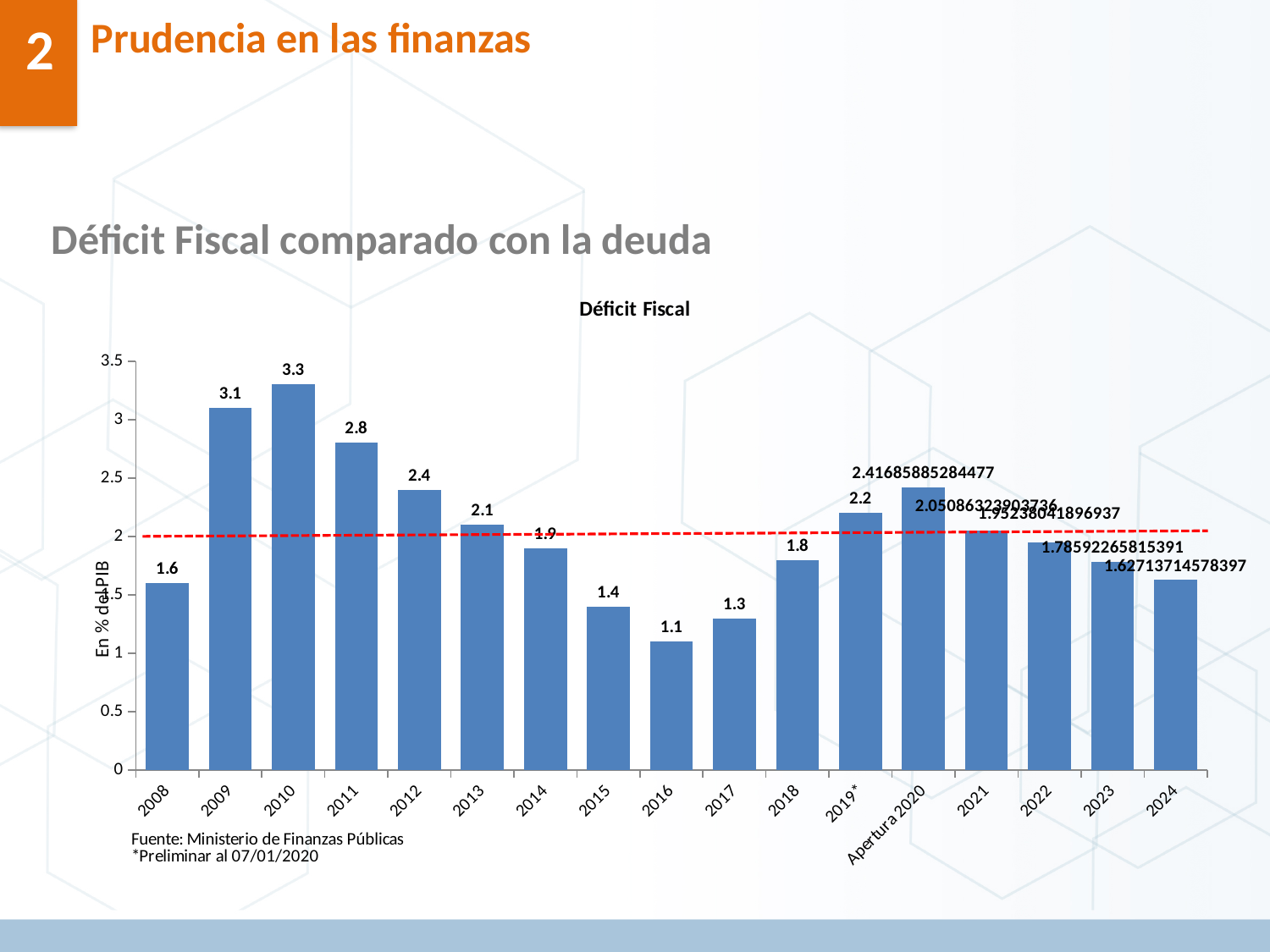
Is the value for 2024 in the Déficit Fiscal chart greater or less than 2? less What kind of chart is the Déficit Fiscal chart? Bar chart What is the value shown for 2023 in the Déficit Fiscal chart? 1.78592265815391 What is the value shown for Apertura 2020 in the Déficit Fiscal chart? 2.41685885284477 What is the value for 2016 in the Déficit Fiscal chart? 1.1 What is the value for 2010 in the Déficit Fiscal chart? 3.3 Which year has the highest value in the Déficit Fiscal chart? 2010 Which year has the lowest value in the Déficit Fiscal chart? 2016 What is the label on the vertical axis of the Déficit Fiscal chart? En % del PIB Which is larger in the Déficit Fiscal chart, the value for 2012 or the value for 2013? 2012 What is the difference between the values for 2009 and 2008 in the Déficit Fiscal chart? 1.5 How many bars are plotted in the Déficit Fiscal chart? 17